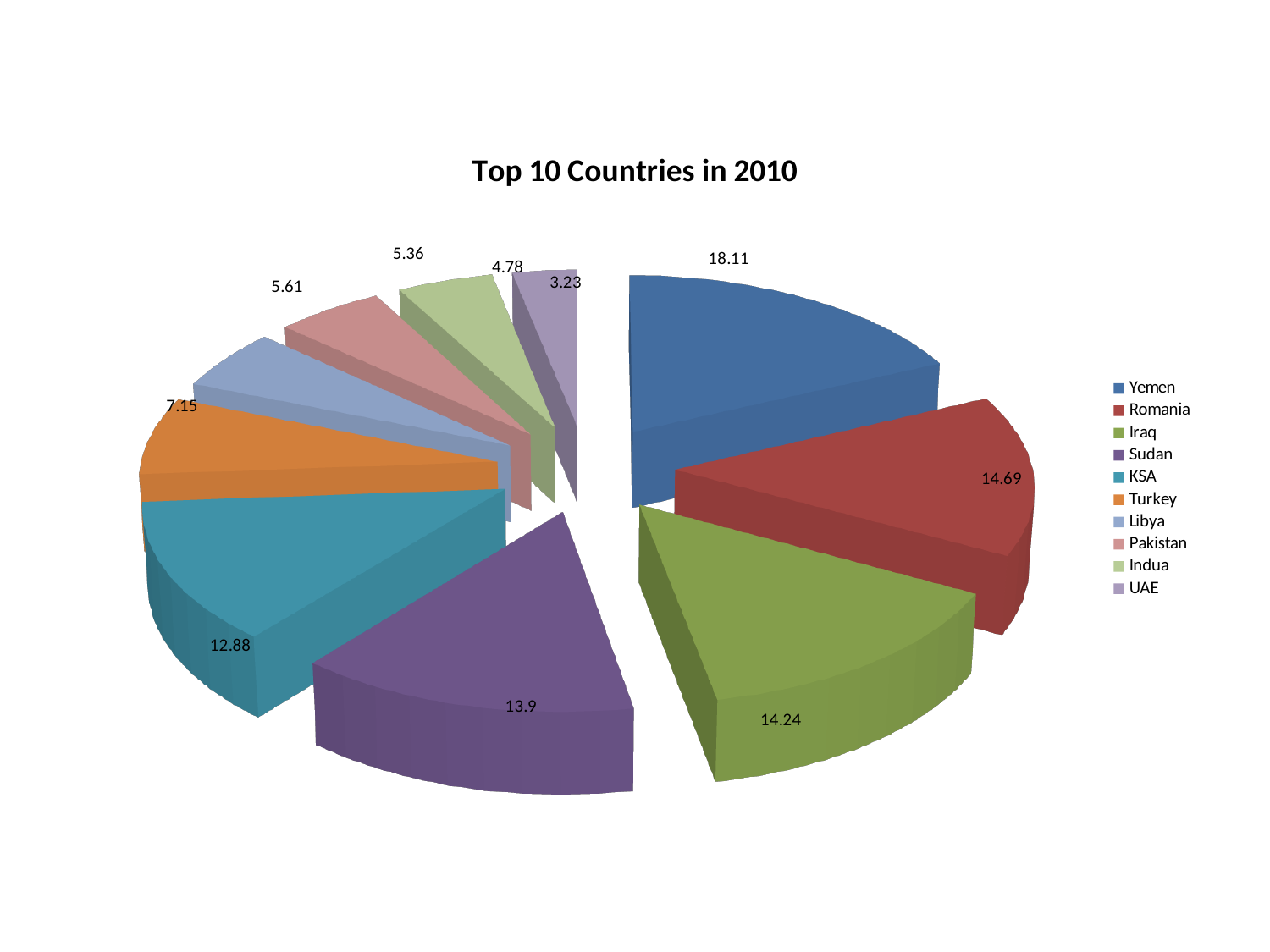
What is the difference between the values for Yemen and Romania? 3.42 Which is larger, the value for Iraq or the value for KSA? Iraq Which country has the smallest slice of the pie? UAE What is the value shown for Sudan? 13.9 Which country has the largest slice of the pie? Yemen What is the difference between the values for Turkey and UAE? 3.92 What is the value shown for KSA? 12.88 What is the value shown for Yemen? 18.11 How many countries are shown in the pie chart? 10 What is the value shown for Turkey? 7.15 What kind of chart is shown on the slide? Pie chart What is the title of the chart? Top 10 Countries in 2010